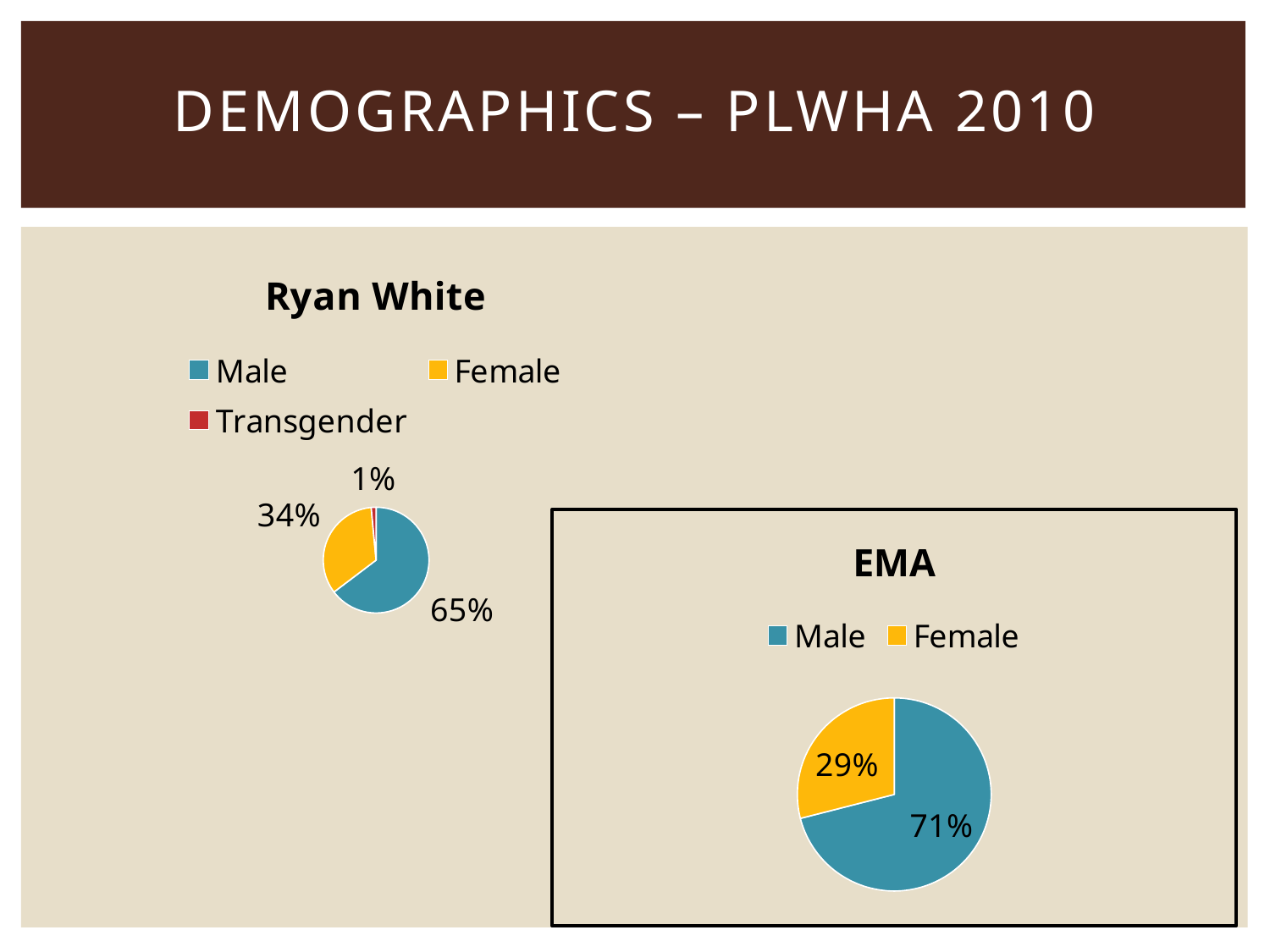
In the EMA chart, what is the difference between the Male and Female shares? 42% In the Ryan White chart, what share of the pie is Male? 65% What kind of chart is the EMA chart? Pie chart In the Ryan White chart, what is the difference between the Male and Female shares? 31% In the EMA chart, which category has the smaller slice? Female In the EMA chart, what share of the pie is Male? 71% In the Ryan White chart, what share of the pie is Female? 34% In the Ryan White chart, which category has the smallest slice? Transgender How many categories does the legend of the Ryan White chart list? 3 In the Ryan White chart, which category has the largest slice? Male